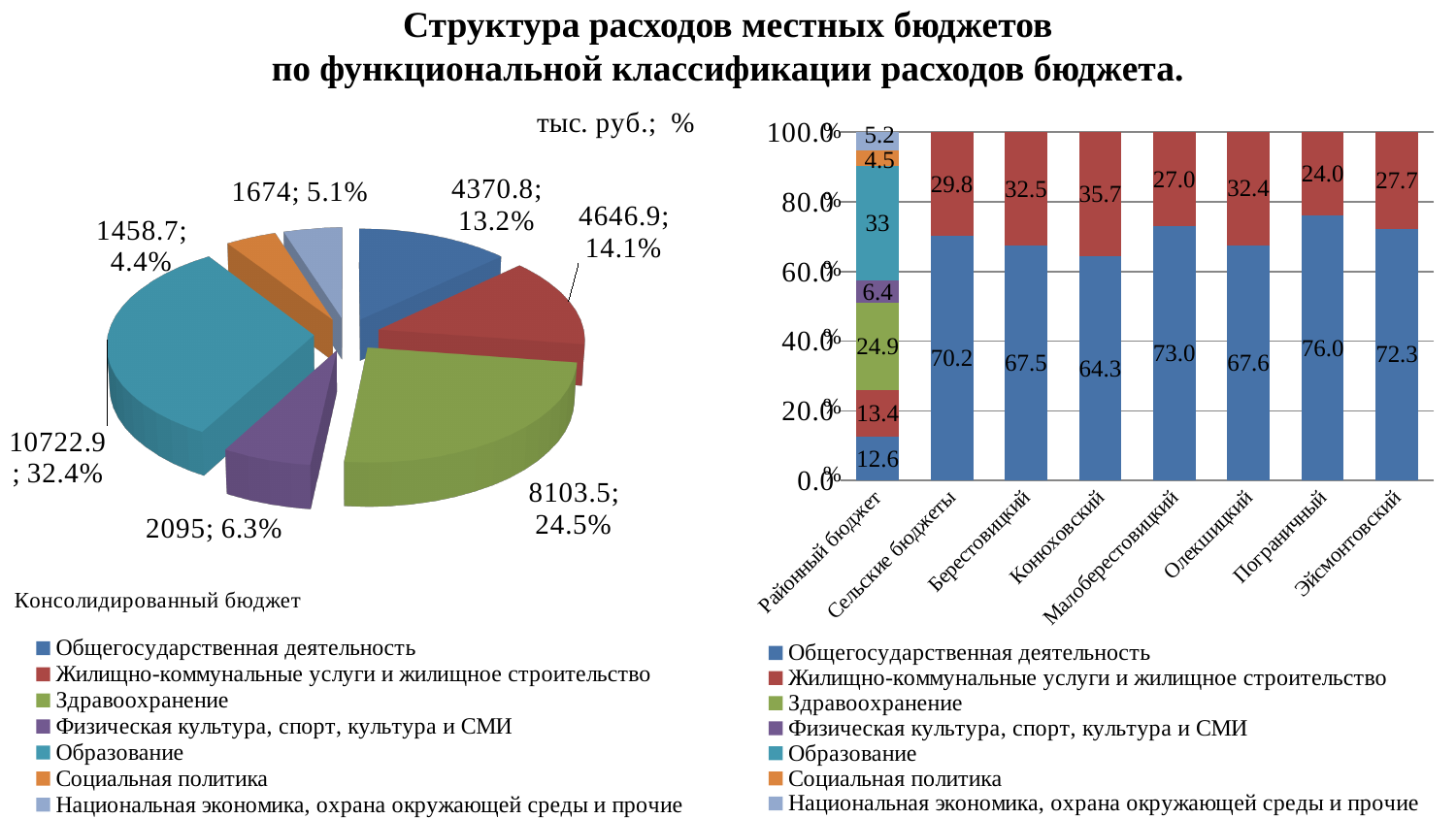
What kind of chart is the right chart? stacked bar chart In the left pie chart, which category has the smallest share? Социальная политика What kind of chart is the left chart (Консолидированный бюджет)? pie chart In the left pie chart, what is the difference in value between Жилищно-коммунальные услуги и жилищное строительство (4646.9) and Общегосударственная деятельность (4370.8)? 276.1 In the left pie chart, which category has the largest share? Образование In the right chart, which category has the highest value for Жилищно-коммунальные услуги и жилищное строительство? Конюховский In the left pie chart, what value and share are shown for Здравоохранение? 8103.5; 24.5% In the right chart, what is the value of Общегосударственная деятельность for Пограничный? 76.0 In the left pie chart, what value and share are shown for Образование? 10722.9; 32.4% How many series does the legend of the right chart list? 7 In the right chart, what is the value of Образование for Районный бюджет? 33 How many categories are shown on the x axis of the right chart? 8